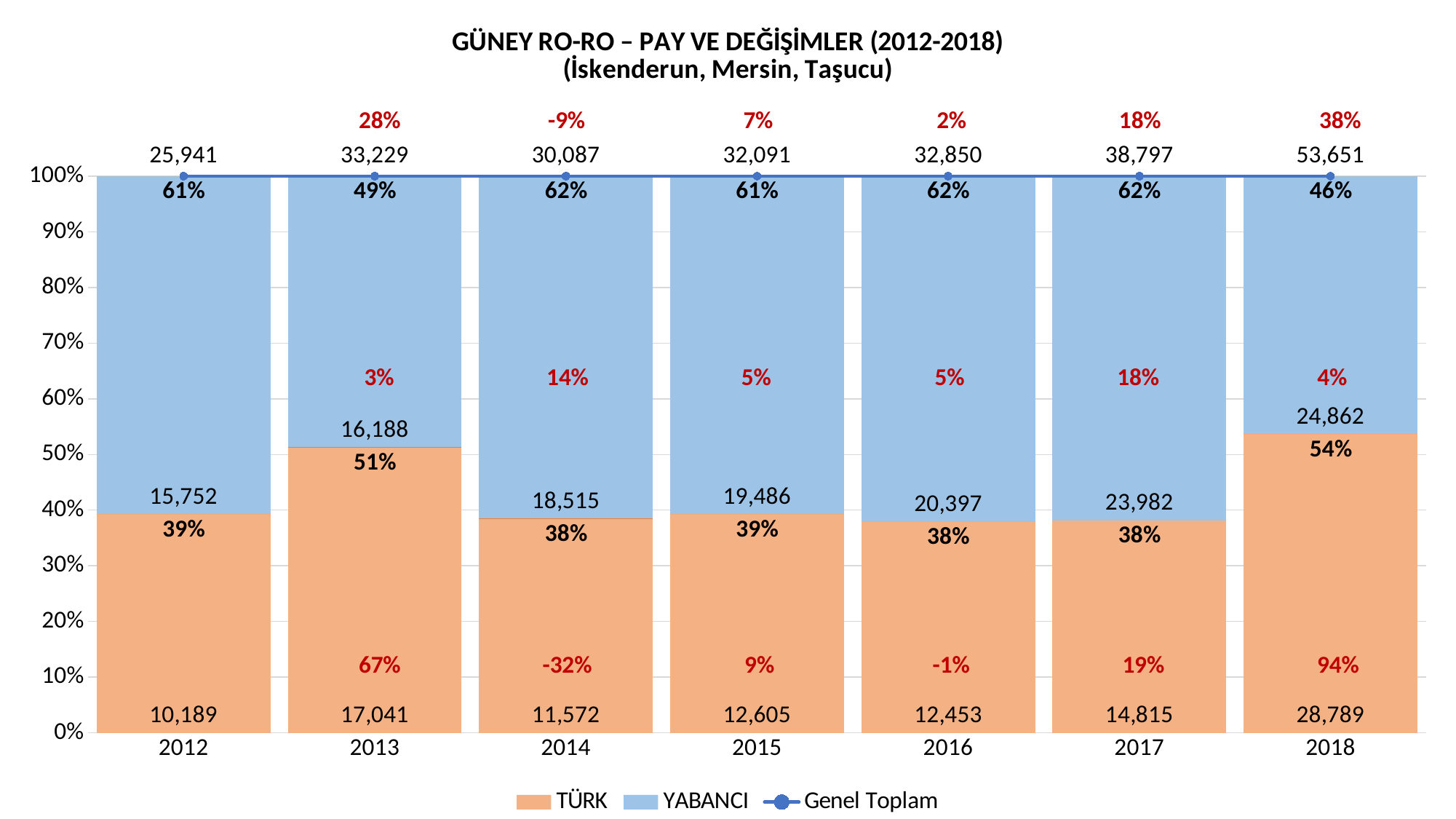
What kind of chart is this? Stacked bar chart with a line What is the YABANCI value for 2014? 18,515 What is the TÜRK value for 2018? 28,789 Which year has the highest Genel Toplam value? 2018 How many series does the legend list? 3 What is the Genel Toplam value for 2017? 38,797 How many years are shown on the x axis? 7 Which year has the lowest TÜRK value? 2012 What is the red percentage change shown above the Genel Toplam value for 2013? 28% In 2013, which is larger, the TÜRK value or the YABANCI value? TÜRK What share of the total does TÜRK hold in 2013? 51% What is the difference between the Genel Toplam values for 2018 and 2017? 14,854